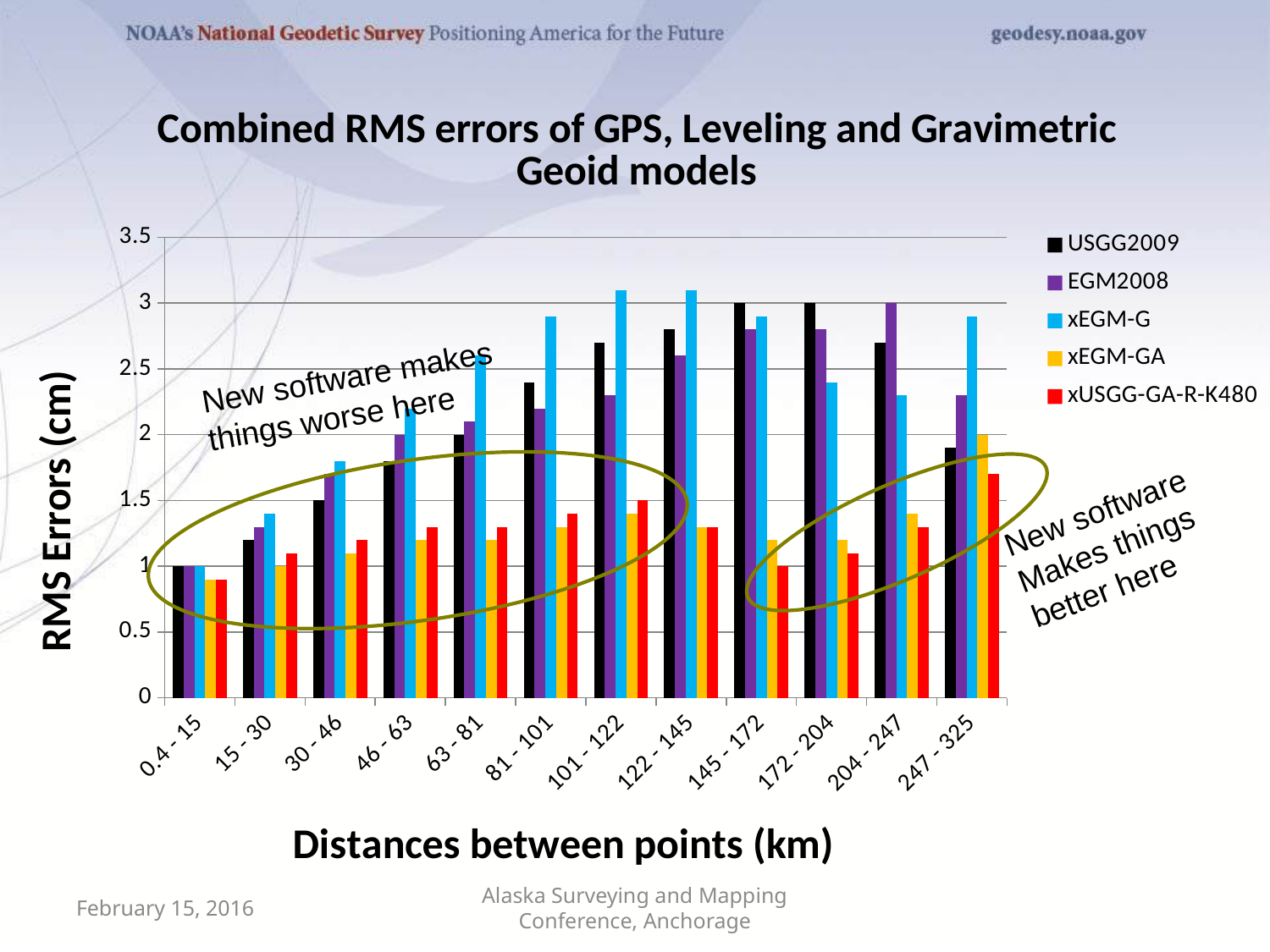
What is the title of the chart? Combined RMS errors of GPS, Leveling and Gravimetric Geoid models At 247 - 325 km, which is larger: xEGM-G or xUSGG-GA-R-K480? xEGM-G Which series has the lowest value at 145 - 172 km? xUSGG-GA-R-K480 Is the value for USGG2009 at 0.4 - 15 km greater or less than 1.5? less Which series has the highest value at 122 - 145 km? xEGM-G Is the value for EGM2008 at 204 - 247 km greater or less than 2.5? greater How many series does the legend list? 5 What is the label of the y axis? RMS Errors (cm) What kind of chart is shown on the slide? bar chart Is the value for xEGM-G at 101 - 122 km greater or less than 2.5? greater How many distance categories are shown on the x axis? 12